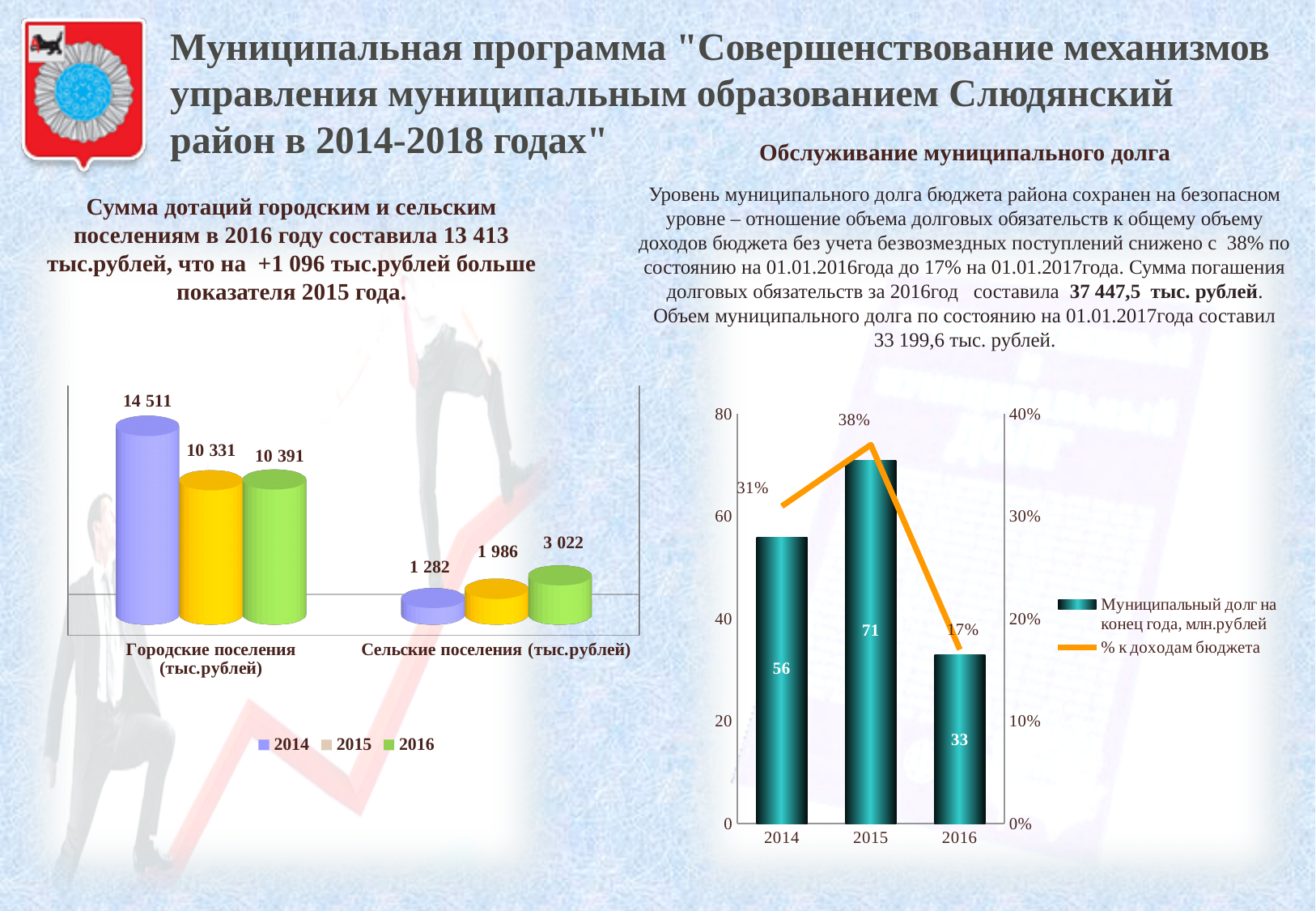
In the right chart (Обслуживание муниципального долга), what is the municipal debt at the end of 2015, in млн.рублей? 71 In the left chart (subsidies to settlements), do the values for Сельские поселения rise or fall from 2014 to 2016? rise In the left chart (subsidies to settlements), which year has the highest value for Городские поселения? 2014 In the left chart (subsidies to settlements), how many series does the legend list? 3 In the right chart (Обслуживание муниципального долга), which year has the lowest municipal debt? 2016 In the left chart (subsidies to settlements), what is the difference between the 2016 and 2015 values for Сельские поселения? 1 036 In the right chart (Обслуживание муниципального долга), what is the difference between the municipal debt in 2015 and in 2016? 38 In the right chart (Обслуживание муниципального долга), what is the % к доходам бюджета for 2016? 17% In the left chart (subsidies to settlements), what is the value for Сельские поселения in 2016? 3 022 In the left chart (subsidies to settlements), what is the value for Городские поселения in 2014? 14 511 In the right chart (Обслуживание муниципального долга), what kind of chart is used for the series Муниципальный долг на конец года? bar chart In the left chart (subsidies to settlements), which year has the lowest value for Сельские поселения? 2014